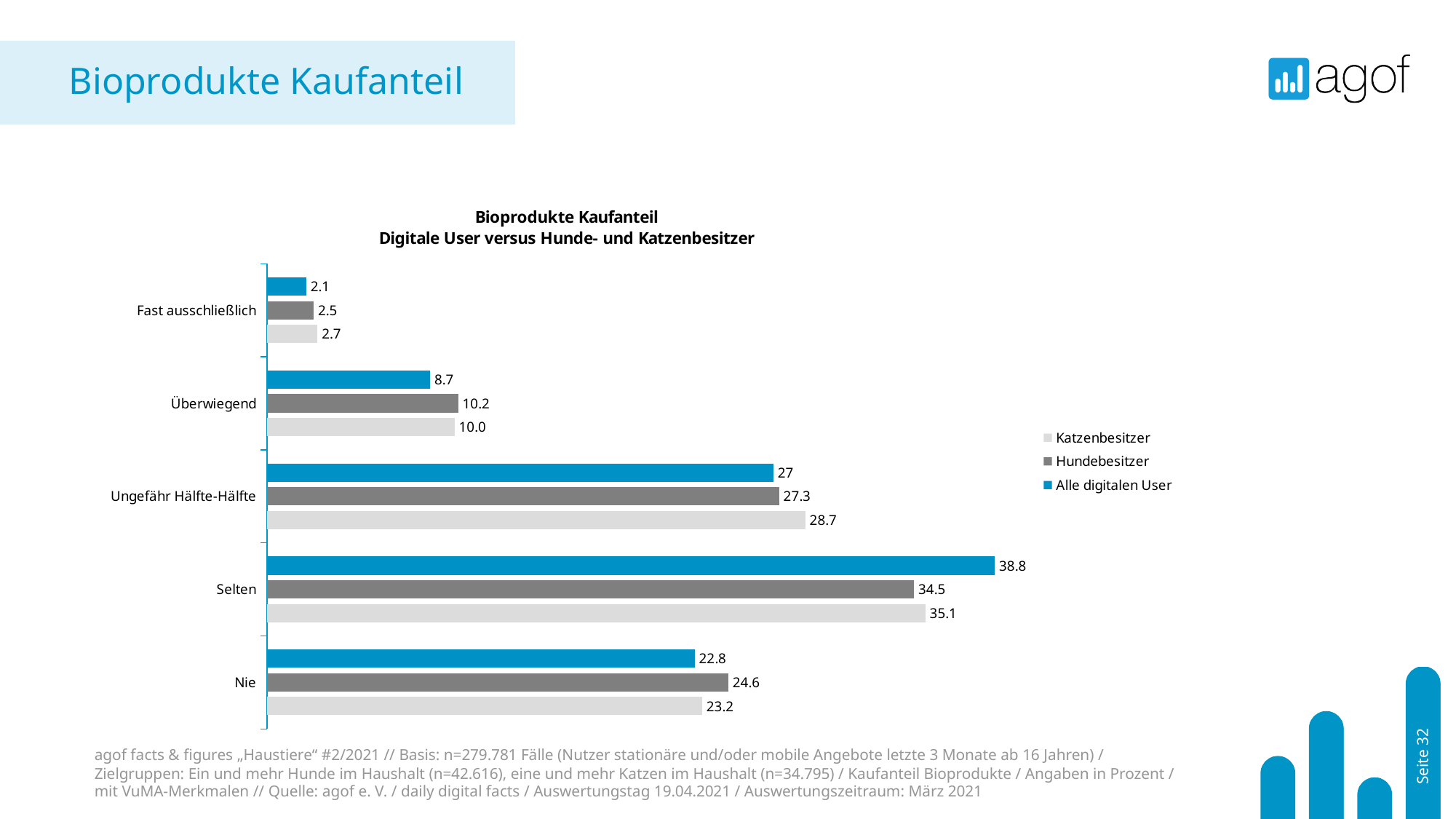
What kind of chart is shown on the slide? Bar chart What is the value for Alle digitalen User in the Nie category? 22.8 What is the difference between the Alle digitalen User and Hundebesitzer values in the Selten category? 4.3 What is the value for Alle digitalen User in the Selten category? 38.8 How many series does the legend list? 3 How many categories are shown on the chart? 5 Which category has the lowest value for Katzenbesitzer? Fast ausschließlich In the Nie category, which is larger: the value for Hundebesitzer or for Katzenbesitzer? Hundebesitzer Which series is shown in blue according to the legend? Alle digitalen User What is the value for Hundebesitzer in the Überwiegend category? 10.2 What is the value for Katzenbesitzer in the Ungefähr Hälfte-Hälfte category? 28.7 Which category has the highest value for Hundebesitzer? Selten